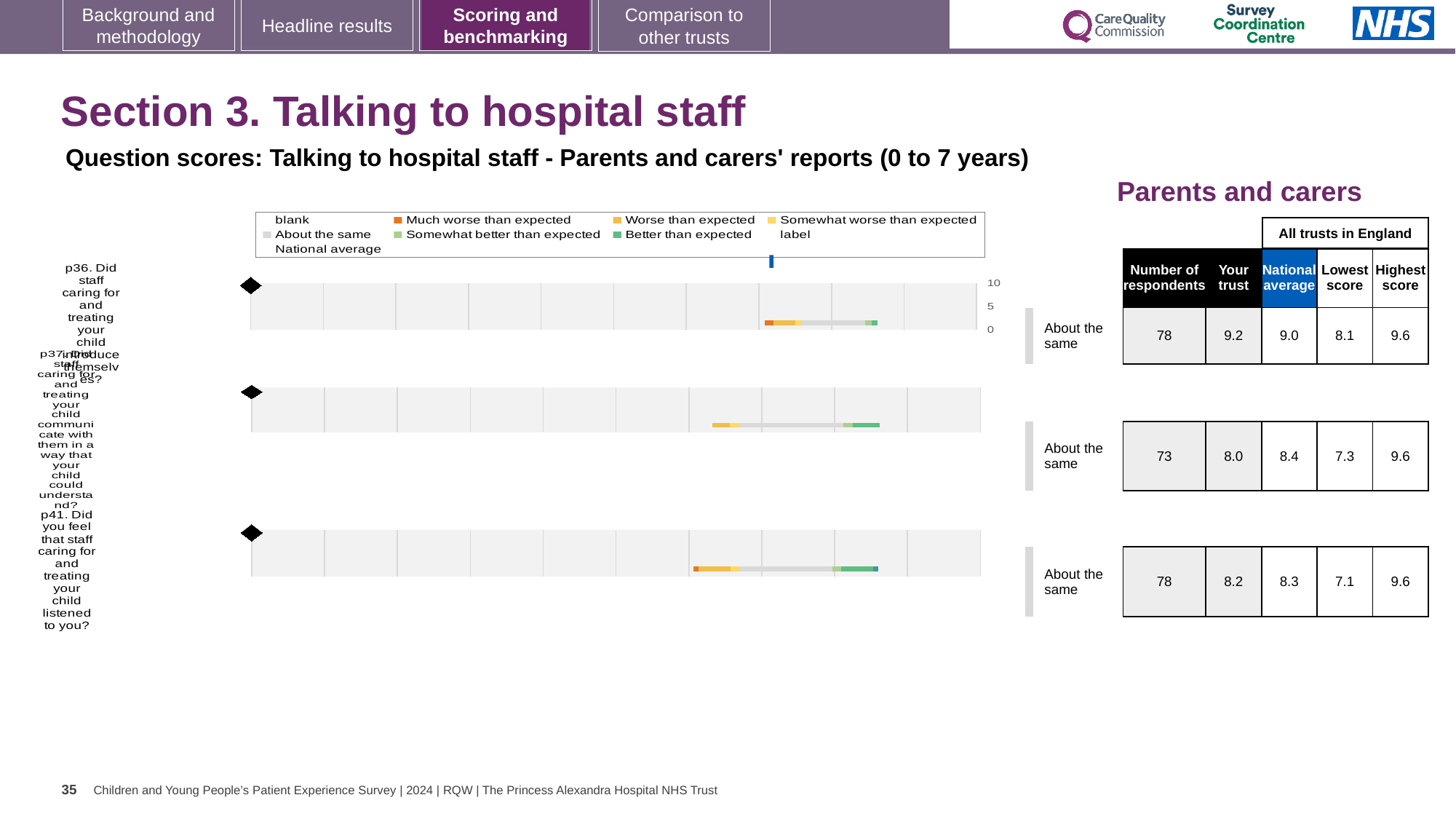
What is the national average score for p37 (Did staff communicate with your child in a way they could understand?)? 8.4 Which of the three questions has the lowest 'Your trust' score? p37 What is the difference between the 'Your trust' score and the national average for p36? 0.2 What is the highest value shown on the chart's score axis? 10 How many respondents answered p41 (Did you feel that staff caring for and treating your child listened to you?)? 78 What is the 'Your trust' score for p36 (Did staff caring for and treating your child introduce themselves?)? 9.2 What is the lowest score across all trusts in England for p41? 7.1 How many survey questions (p36, p37, p41) have a chart row on this slide? 3 Which of the three questions has the highest 'Your trust' score? p36 What benchmark category is shown for all three questions on this slide? About the same For p37, which is larger: the 'Your trust' score or the national average? National average What kind of chart is used to show the question scores on this slide? bar chart